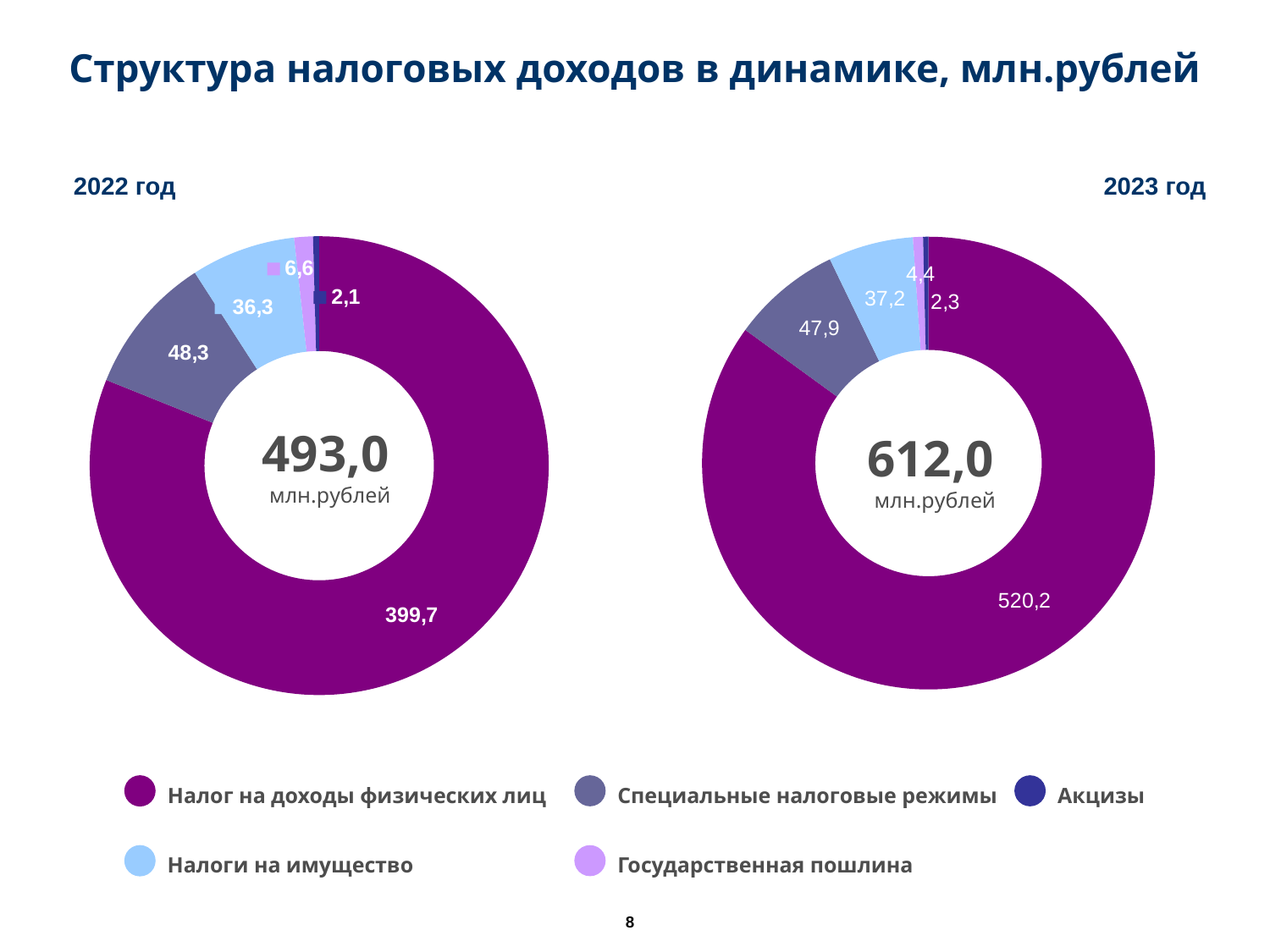
What is the title of the slide? Структура налоговых доходов в динамике, млн.рублей Is the value for Налоги на имущество larger on the 2022 год chart or the 2023 год chart? 2023 год On the 2022 год chart, which category has the smallest value? Акцизы On the 2022 год chart, what is the value for Налоги на имущество? 36,3 On the 2023 год chart, what is the value for Государственная пошлина? 4,4 How many categories does the legend list? 5 On the 2022 год chart, what is the value for Налог на доходы физических лиц? 399,7 What is the difference between the Налог на доходы физических лиц values on the 2023 год chart and the 2022 год chart? 120,5 What total is shown in the centre of the 2023 год chart? 612,0 млн.рублей What type of chart is used for the 2022 год data? Donut (pie) chart On the 2023 год chart, which category has the largest value? Налог на доходы физических лиц On the 2023 год chart, what is the value for Специальные налоговые режимы? 47,9